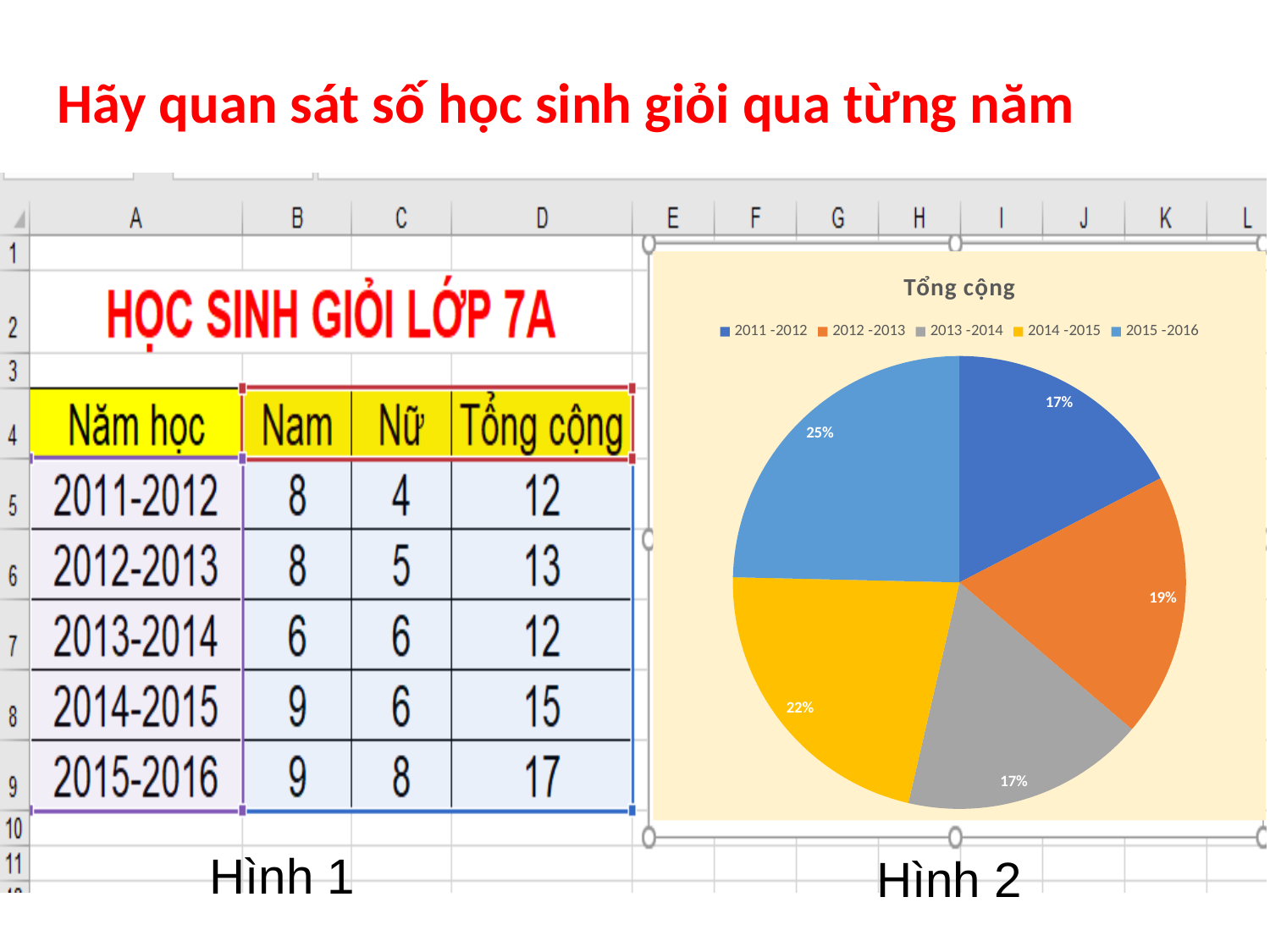
What colour is the 2014 -2015 slice in the pie chart? yellow In the pie chart, what is the difference in percentage points between the 2015 -2016 slice and the 2013 -2014 slice? 8 What share of the pie chart does 2012 -2013 represent? 19% What share of the pie chart does 2015 -2016 represent? 25% How many entries does the pie chart's legend list? 5 What share of the pie chart does 2014 -2015 represent? 22% What is the title of the pie chart? Tổng cộng How many slices does the pie chart have? 5 In the pie chart, which slice is larger: 2014 -2015 or 2012 -2013? 2014 -2015 Which school year has the largest slice in the pie chart? 2015 -2016 What type of chart is shown in Hình 2? pie chart